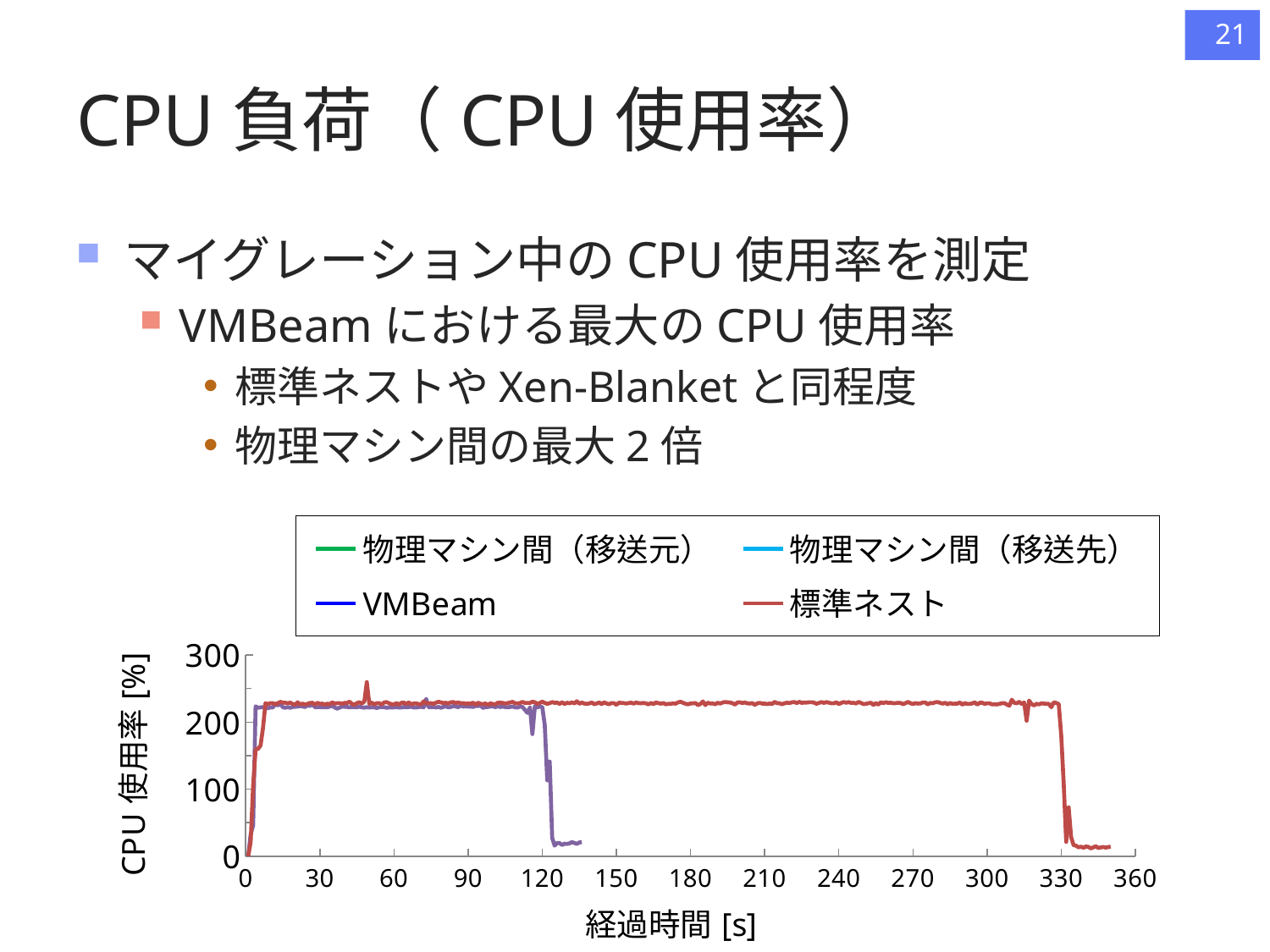
What is the highest value shown on the chart's y axis? 300 Is the CPU usage of 標準ネスト at 345 s greater or less than 100? less What is the label of the chart's y axis? CPU 使用率 [%] Does the CPU usage of VMBeam rise or fall between 0 s and 10 s? rise Is the CPU usage of 標準ネスト at 200 s greater or less than 200? greater Is the CPU usage of VMBeam at 130 s greater or less than 100? less How many series does the chart's legend list? 4 Does the CPU usage of 標準ネスト rise or fall between 330 s and 340 s? fall What is the label of the chart's x axis? 経過時間 [s] What kind of chart is shown on the slide? line chart At 130 s, which series has the higher CPU usage, VMBeam or 標準ネスト? 標準ネスト